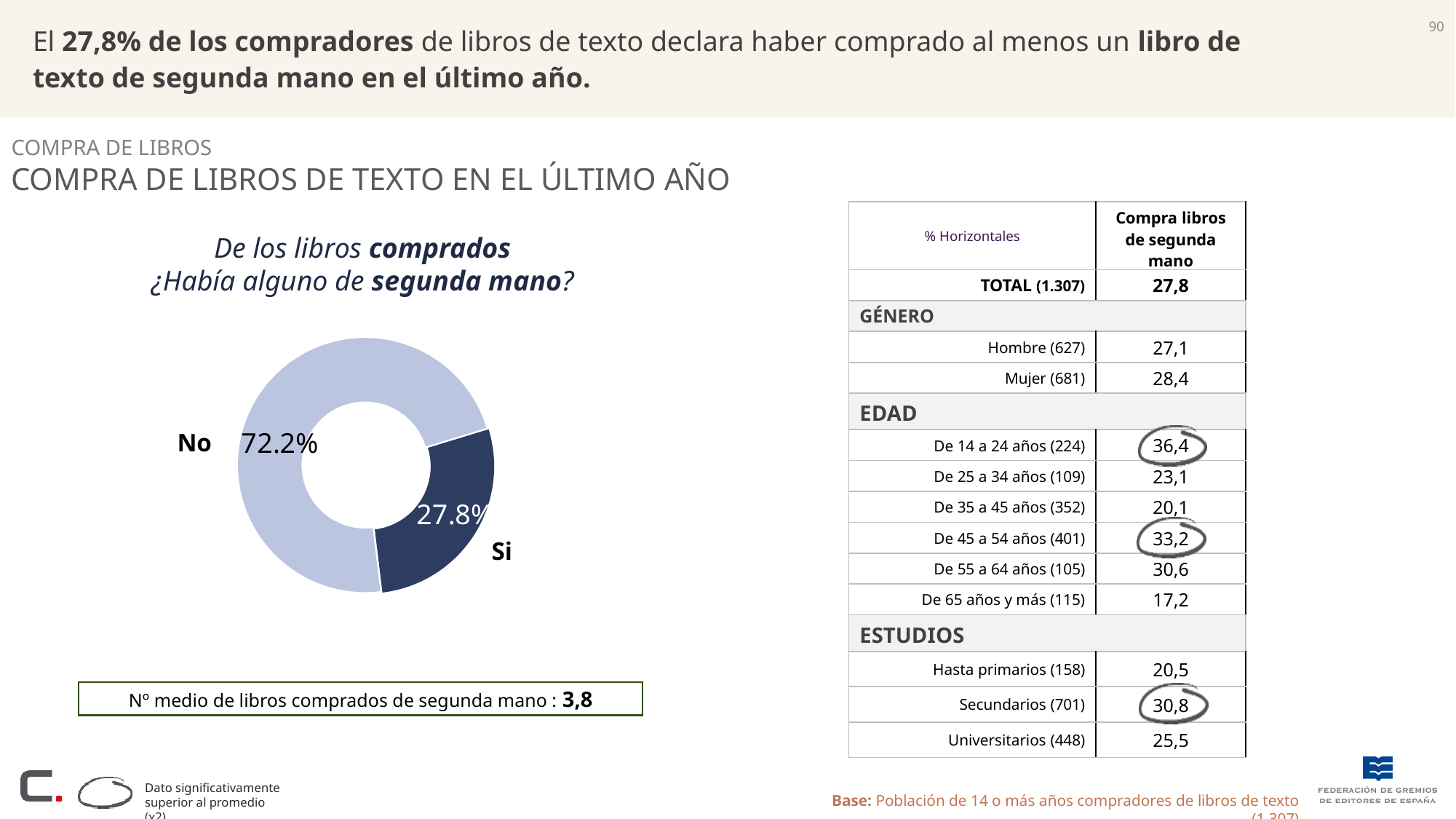
What percentage is shown for the 'Si' slice of the pie chart? 27.8% Which is larger in the pie chart, 'Si' or 'No'? No What percentage is shown for the 'No' slice of the pie chart? 72.2% What kind of chart is shown on the slide? doughnut chart What is the difference in percentage points between the 'No' and 'Si' slices of the pie chart? 44.4 Which slice of the pie chart is drawn in dark navy blue? Si Which slice of the pie chart is the largest? No How many slices does the pie chart have? 2 Which slice of the pie chart is the smallest? Si What question is posed as the title above the pie chart? De los libros comprados ¿Había alguno de segunda mano? What share of the pie chart does the 'Si' slice represent? 27.8%